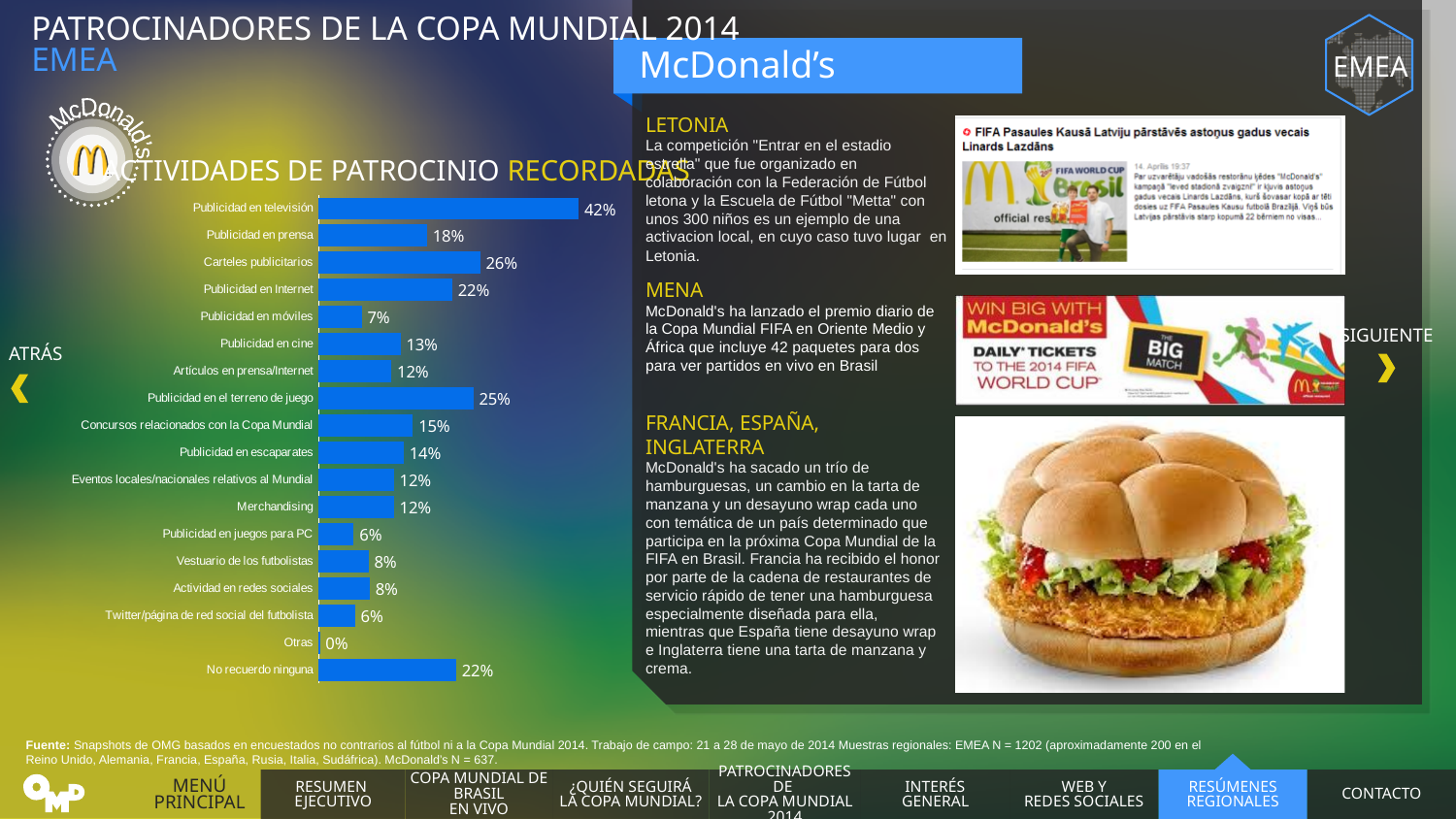
What is the value shown for 'Publicidad en el terreno de juego'? 25% What is the difference between the values for 'Carteles publicitarios' and 'Publicidad en Internet'? 4% What type of chart is used to show the recalled sponsorship activities? Bar chart What percentage of respondents recalled 'Publicidad en televisión'? 42% What is the value shown for 'No recuerdo ninguna'? 22% Which is larger: the value for 'Publicidad en cine' or the value for 'Publicidad en móviles'? Publicidad en cine Which category has the lowest value in the chart? Otras What is the difference between the values for 'Publicidad en televisión' and 'Publicidad en prensa'? 24% What is the value shown for 'Carteles publicitarios'? 26% How many categories are plotted in the bar chart? 18 Which sponsorship activity has the highest recall value in the chart? Publicidad en televisión What is the title of the chart on the slide? ACTIVIDADES DE PATROCINIO RECORDADAS